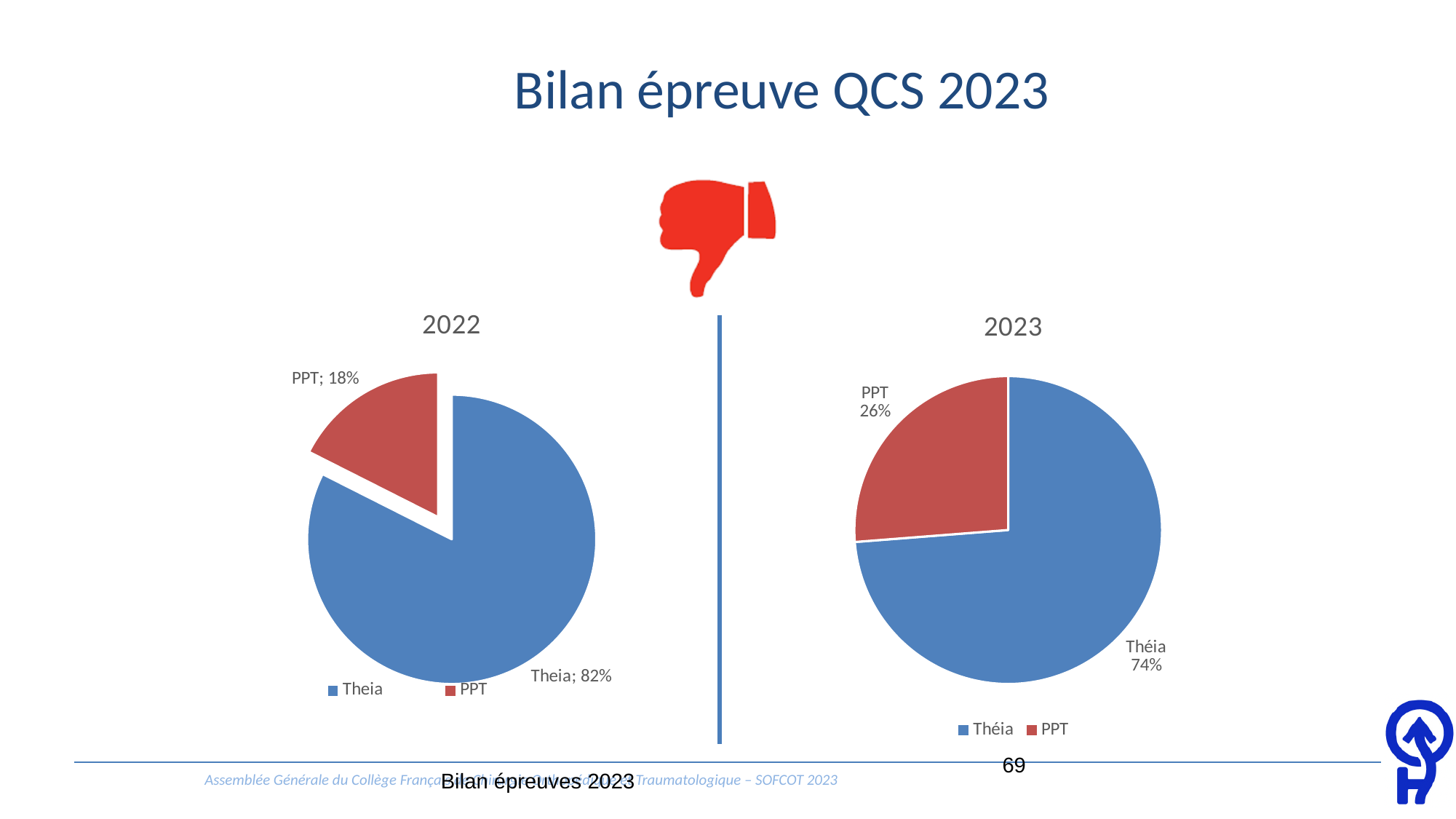
What kind of chart is the 2023 chart? Pie chart In the 2023 chart, what colour is the PPT slice? Red In the 2023 chart, which slice is the smallest? PPT In the 2023 chart, what share does Théia have? 74% Is the PPT share larger in the 2022 chart or the 2023 chart? 2023 In the 2023 chart, what is the difference between the Théia and PPT shares? 48% In the 2022 chart, what is the difference between the Theia and PPT shares? 64% In the 2022 chart, which slice is the largest? Theia How many slices does the 2022 chart have? 2 In the 2023 chart, what share does PPT have? 26% In the 2022 chart, what share does Theia have? 82% In the 2022 chart, what share does PPT have? 18%